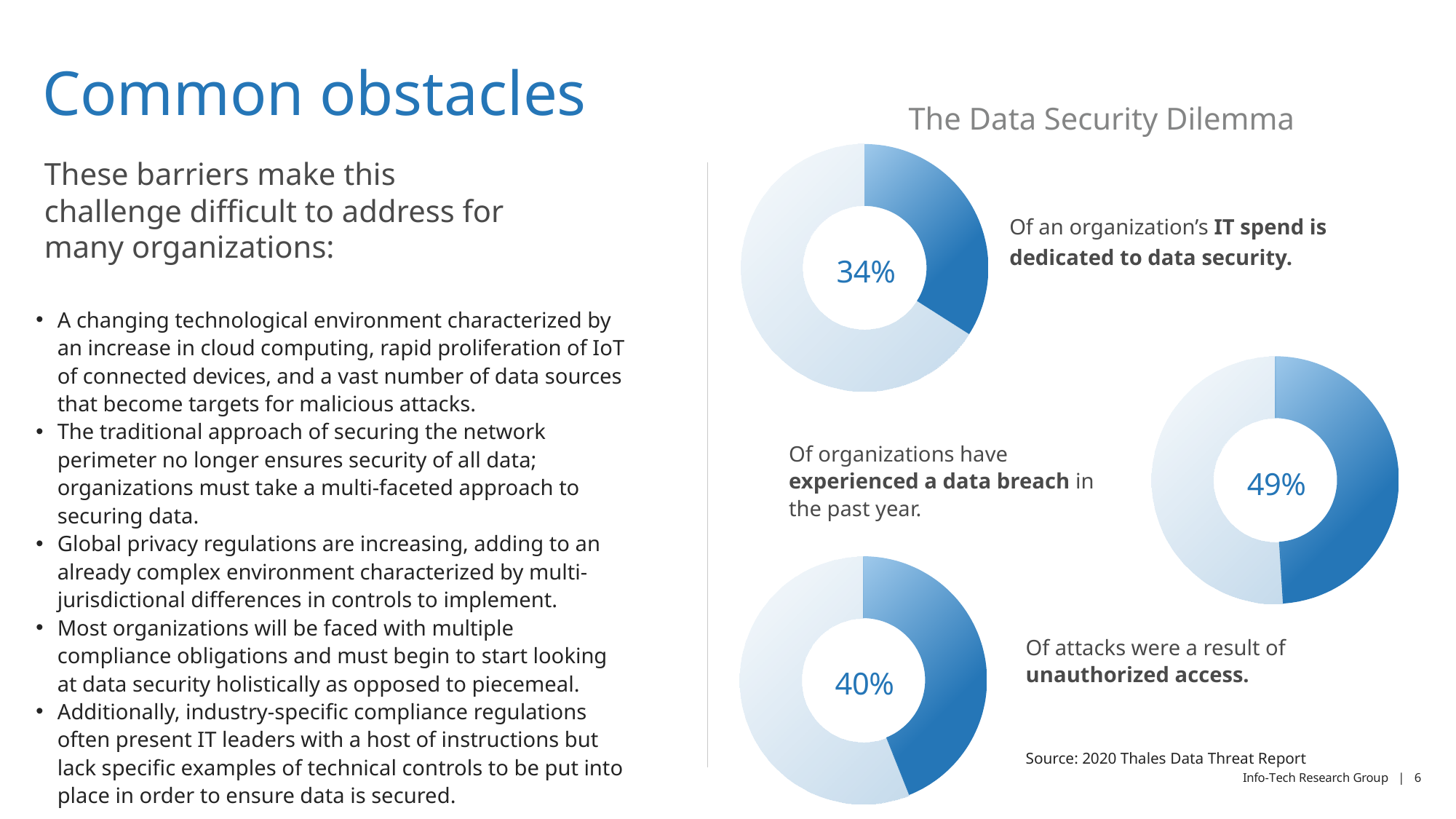
In the bottom-left donut chart, what percentage of attacks were a result of unauthorized access? 40% What is the difference between the percentage of attacks resulting from unauthorized access and the percentage of IT spend dedicated to data security? 6% Which of the three donut charts shows the lowest percentage? The top-left chart (34%, IT spend dedicated to data security) Which is larger: the percentage of attacks from unauthorized access or the percentage of organizations that experienced a data breach? Organizations that experienced a data breach (49%) What is the title above the group of charts on the right side of the slide? The Data Security Dilemma What type of chart is used to display the percentages on the slide? Donut chart In the right-hand donut chart, what percentage of organizations have experienced a data breach in the past year? 49% How many donut charts are shown on the slide? 3 What source is cited for the data in the charts? 2020 Thales Data Threat Report In the top-left donut chart, what percentage of an organization's IT spend is dedicated to data security? 34% Which of the three donut charts shows the highest percentage? The right-hand chart (49%, experienced a data breach) What is the difference between the percentage of organizations that experienced a data breach and the percentage of IT spend dedicated to data security? 15%